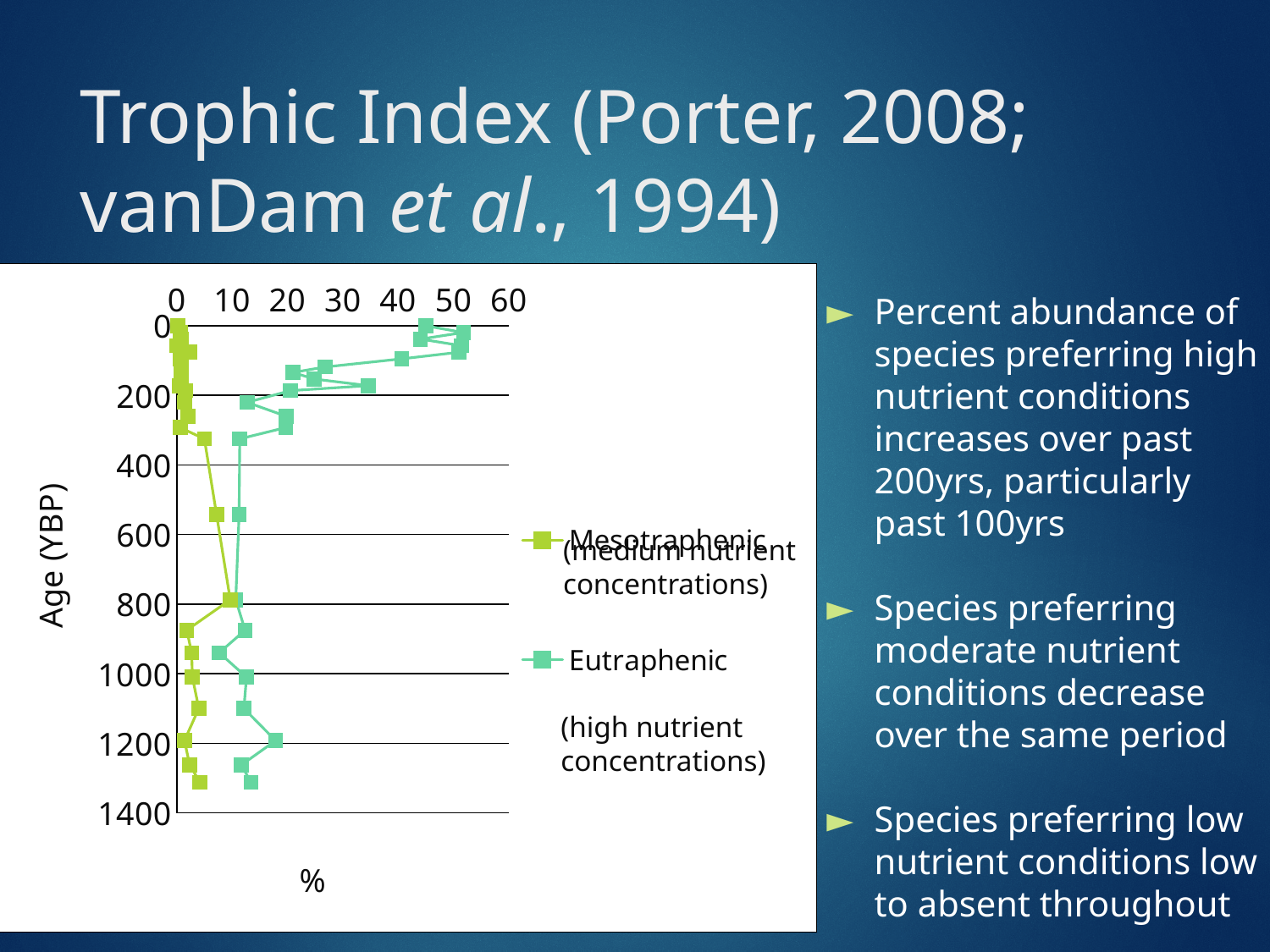
What is the maximum value shown on the percentage axis? 60 Is the Mesotraphenic value at around 1200 YBP greater or less than 10%? less Which series reaches the highest percentage anywhere in the chart? Eutraphenic What are the two series named in the chart legend? Mesotraphenic and Eutraphenic How many series does the legend list? 2 What kind of chart is shown on the slide? line chart Which series has the higher value at the most recent age (near 0 YBP), Mesotraphenic or Eutraphenic? Eutraphenic Is the Eutraphenic value at the most recent age (near 0 YBP) greater or less than 40%? greater Is the Eutraphenic value at around 1200 YBP greater or less than 10%? greater Does the Eutraphenic percentage rise or fall as age moves from 1400 YBP toward 0 YBP? rise What is the label of the vertical axis of the chart? Age (YBP)